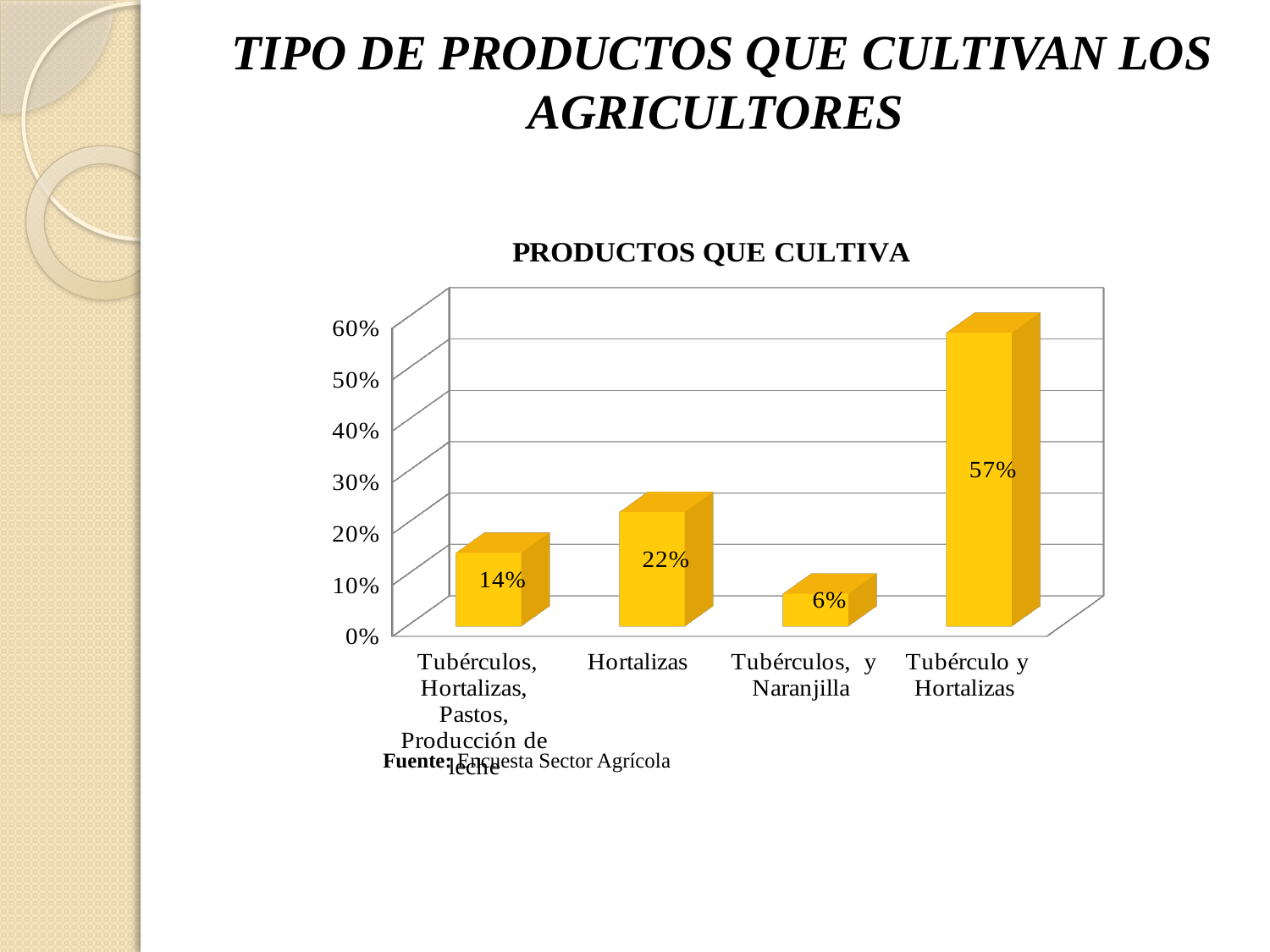
Which is larger, the value for Hortalizas or the value for Tubérculos, Hortalizas, Pastos, Producción de leche? Hortalizas What is the title of the chart? PRODUCTOS QUE CULTIVA What is the value for Tubérculos, Hortalizas, Pastos, Producción de leche? 14% What is the value for Hortalizas? 22% How many categories are shown on the chart? 4 What is the difference between the values for Tubérculo y Hortalizas and Hortalizas? 35% What kind of chart is shown on the slide? Bar chart Which category has the highest value? Tubérculo y Hortalizas What is the difference between the values for Hortalizas and Tubérculos, y Naranjilla? 16% What is the value for Tubérculos, y Naranjilla? 6% Which category has the lowest value? Tubérculos, y Naranjilla What is the value for Tubérculo y Hortalizas? 57%